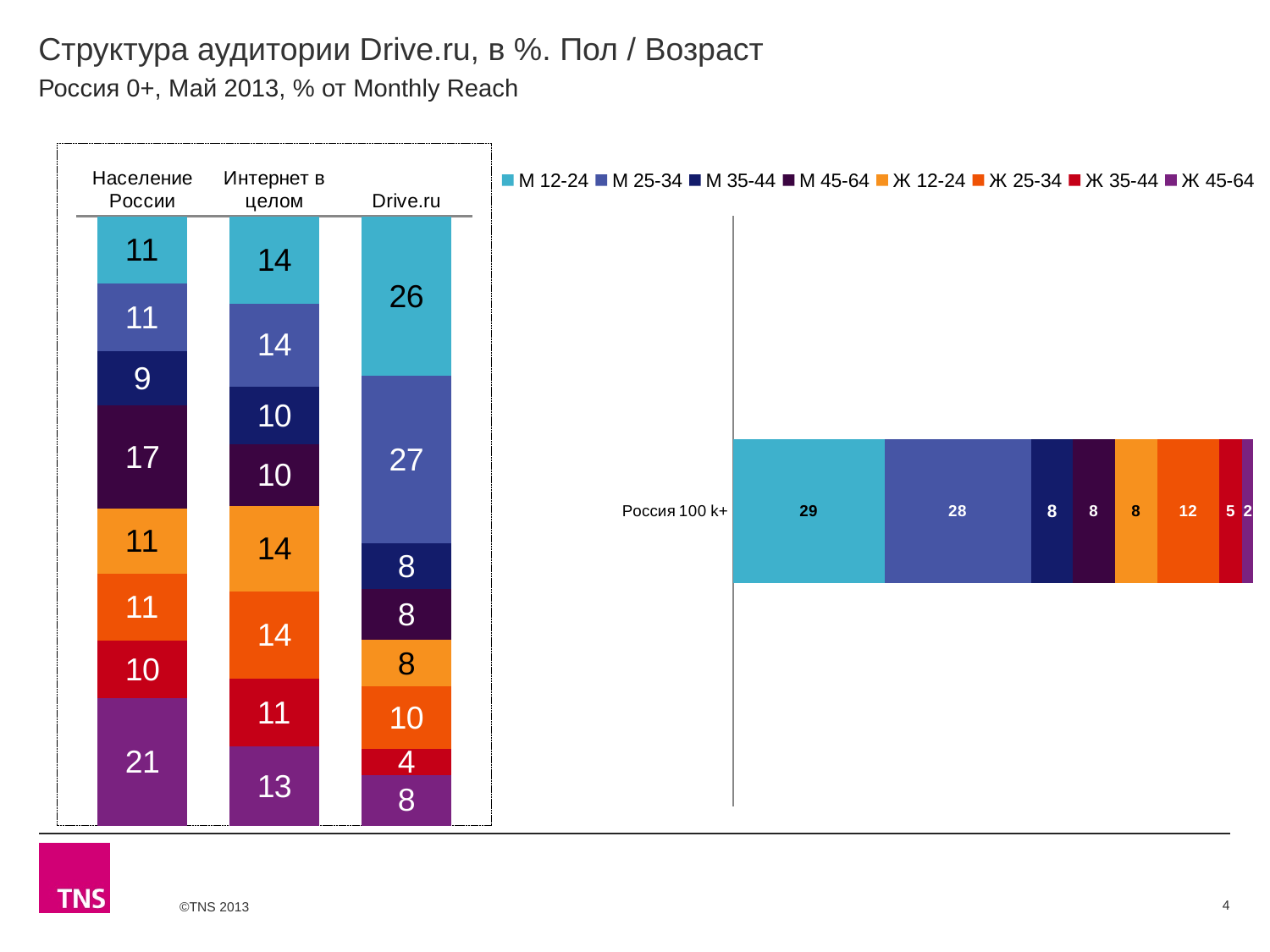
In the left chart, which segment of the Drive.ru bar has the smallest value? Ж 35-44 In the right chart (Россия 100 k+), what is the value of the М 25-34 segment? 28 In the right chart (Россия 100 k+), which segment has the smallest value? Ж 45-64 In the left chart, which is larger: the Ж 45-64 value for Население России or for Интернет в целом? Население России In the left chart, what is the value of the Ж 45-64 segment for Население России? 21 What type of chart is the right chart (Россия 100 k+)? Stacked bar chart How many series does the legend list? 8 How many bars are plotted in the left chart? 3 In the left chart, what is the value of the М 35-44 segment for Интернет в целом? 10 In the left chart, what is the difference between the М 12-24 value for Drive.ru and the М 12-24 value for Население России? 15 In the left chart, what is the value of the М 12-24 segment for Drive.ru? 26 In the left chart, which segment of the Drive.ru bar has the largest value? М 25-34